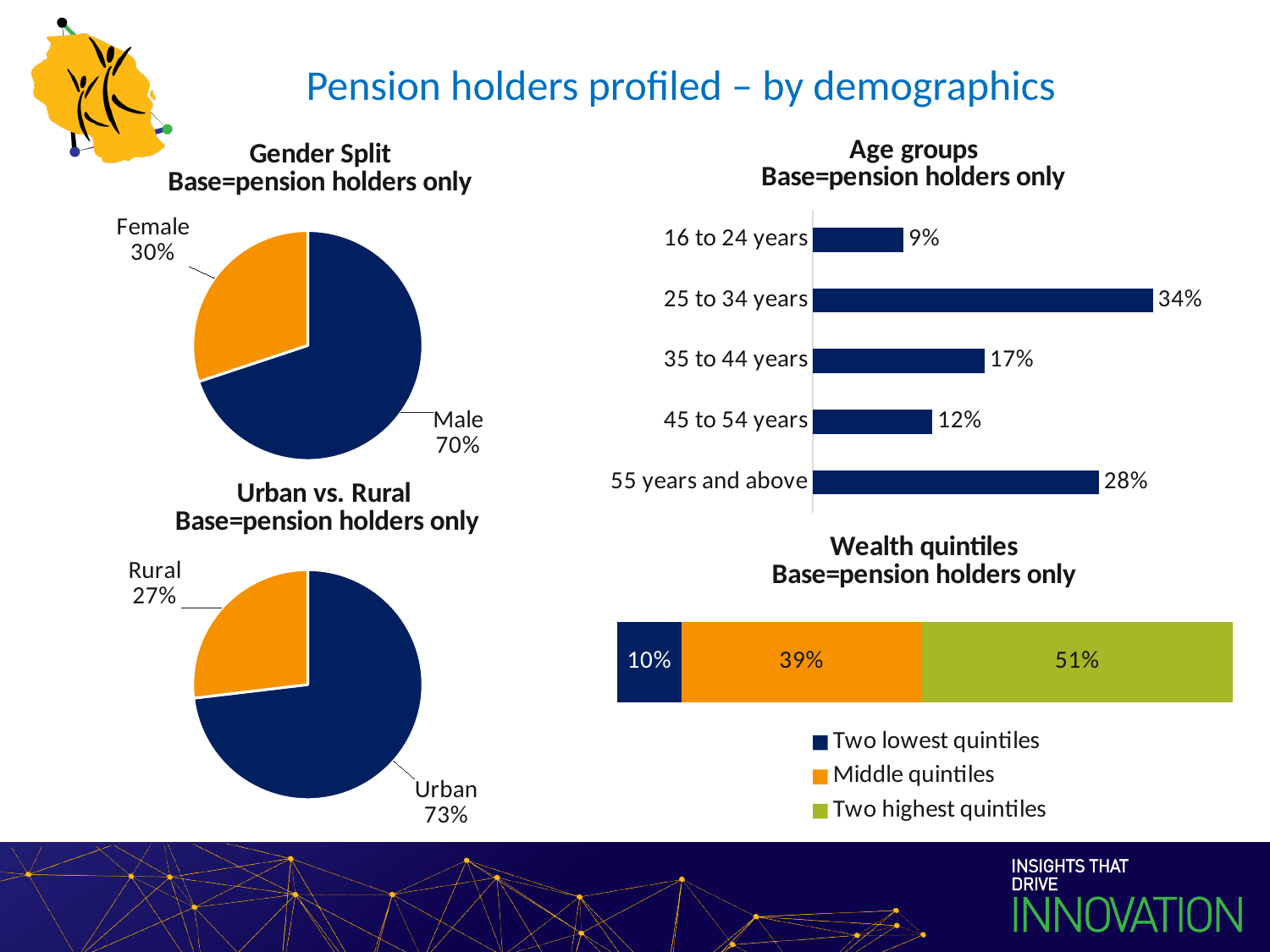
In the Gender Split chart, what share of pension holders are Female? 30% In the Age groups chart, how many age groups are shown? 5 In the Gender Split chart, what share of pension holders are Male? 70% In the Age groups chart, which age group has the highest value? 25 to 34 years In the Urban vs. Rural chart, what is the difference between the Urban and Rural shares? 46% In the Age groups chart, which age group has the lowest value? 16 to 24 years In the Urban vs. Rural chart, what is the value for Rural? 27% In the Age groups chart, what is the value for 55 years and above? 28% What kind of chart is the Urban vs. Rural chart? Pie chart In the Wealth quintiles chart, what is the value for Middle quintiles? 39% In the Age groups chart, which is larger: 35 to 44 years or 45 to 54 years? 35 to 44 years How many series does the legend of the Wealth quintiles chart list? 3